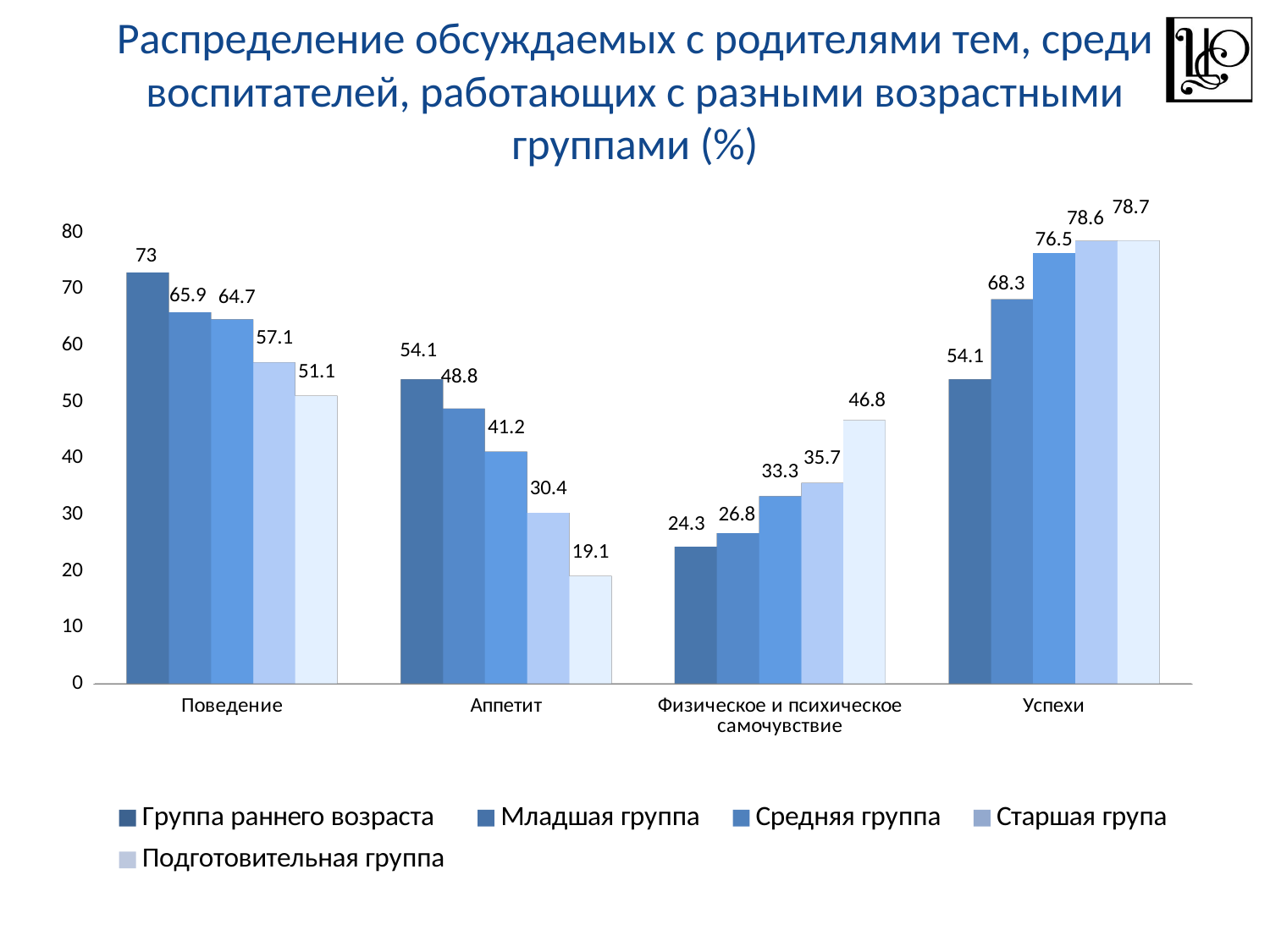
What is the difference between Группа раннего возраста and Подготовительная группа in the Поведение category? 21.9 Which category has the highest value for Старшая група? Успехи How many categories are shown on the x axis? 4 What is the value for Группа раннего возраста in the Поведение category? 73 What is the value for Подготовительная группа in the Аппетит category? 19.1 Which series has the highest value in the Физическое и психическое самочувствие category? Подготовительная группа Which series has the lowest value in the Аппетит category? Подготовительная группа What is the value for Средняя группа in the Успехи category? 76.5 How many series does the legend list? 5 Which is larger: Младшая группа in Успехи or Младшая группа in Поведение? Младшая группа in Успехи What kind of chart is shown on the slide? bar chart Do the values for the Аппетит category rise or fall from Группа раннего возраста to Подготовительная группа? fall